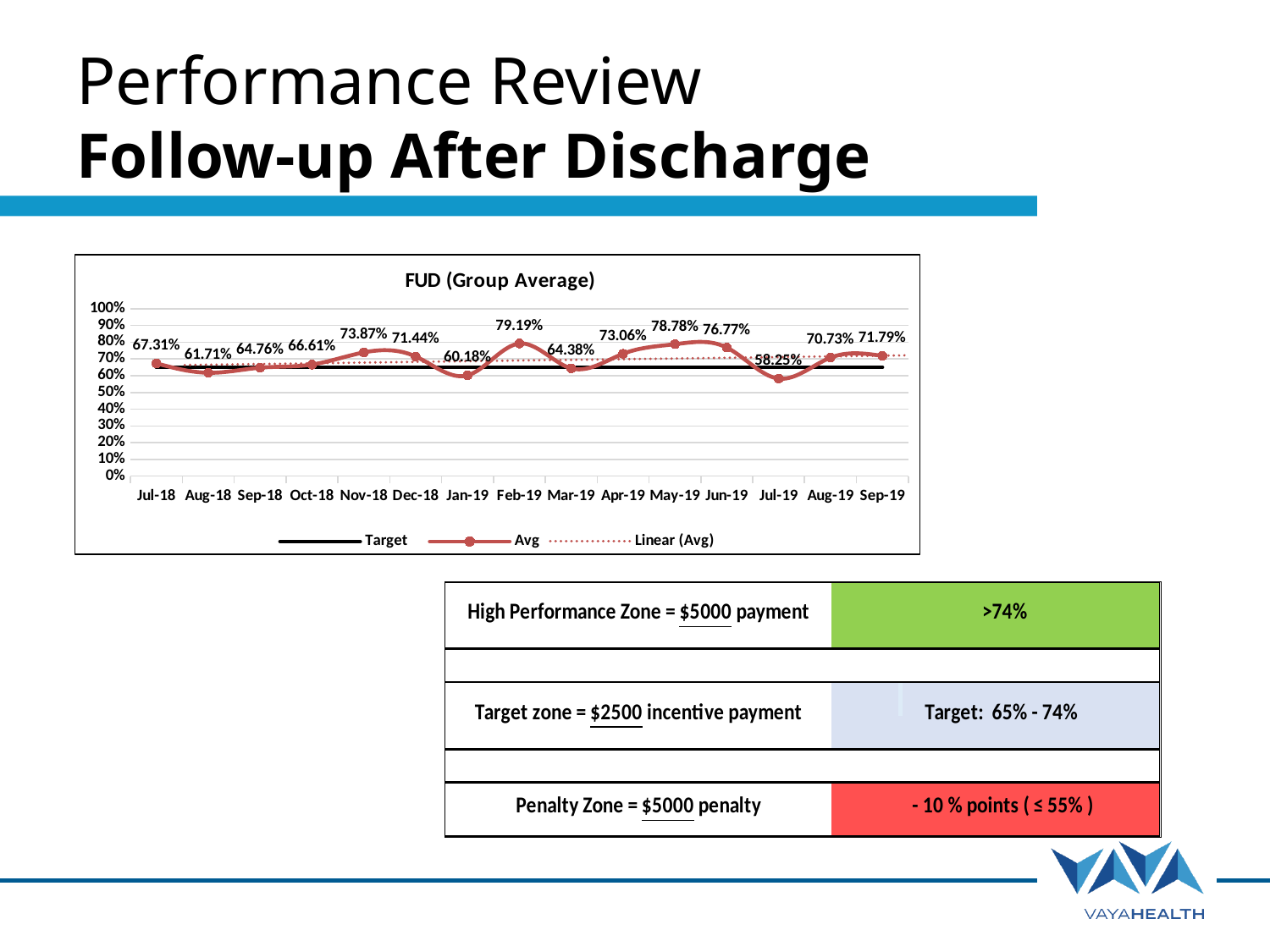
What kind of chart is the FUD (Group Average) chart? Line chart How many months are plotted on the x axis of the FUD (Group Average) chart? 15 Is the Avg value for Jul-19 in the FUD (Group Average) chart greater or less than 60%? less Which month has a higher Avg value in the FUD (Group Average) chart, Nov-18 or Dec-18? Nov-18 What are the three legend entries in the FUD (Group Average) chart? Target, Avg, Linear (Avg) What is the difference in percentage points between the Avg values for Feb-19 and Jul-19 in the FUD (Group Average) chart? 20.94 What is the Avg value for Jul-18 in the FUD (Group Average) chart? 67.31% Which month has the highest Avg value in the FUD (Group Average) chart? Feb-19 Which month has the lowest Avg value in the FUD (Group Average) chart? Jul-19 What is the Avg value for Jul-19 in the FUD (Group Average) chart? 58.25% What is the Avg value for Feb-19 in the FUD (Group Average) chart? 79.19% How many series does the legend of the FUD (Group Average) chart list? 3